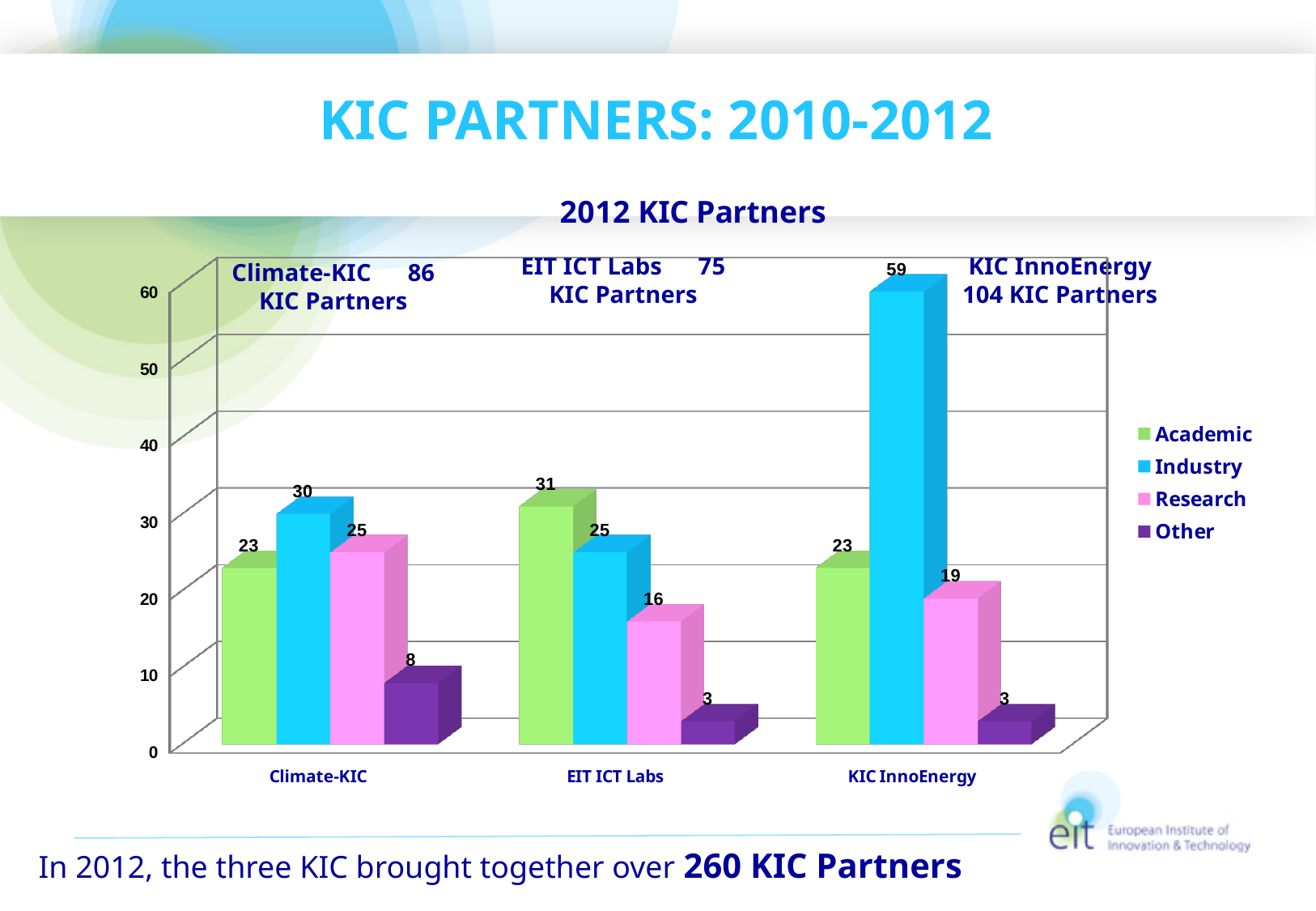
What is the Industry value for KIC InnoEnergy? 59 How many KICs are shown on the x axis? 3 What kind of chart is shown? bar chart Which is larger, the Research value for Climate-KIC or the Research value for KIC InnoEnergy? Climate-KIC What is the title of the chart? 2012 KIC Partners What is the Other value for Climate-KIC? 8 What is the Research value for KIC InnoEnergy? 19 Which KIC has the lowest Research value? EIT ICT Labs What is the Academic value for EIT ICT Labs? 31 What is the difference between the Industry values for KIC InnoEnergy and Climate-KIC? 29 How many series does the legend list? 4 Which KIC has the highest Industry value? KIC InnoEnergy